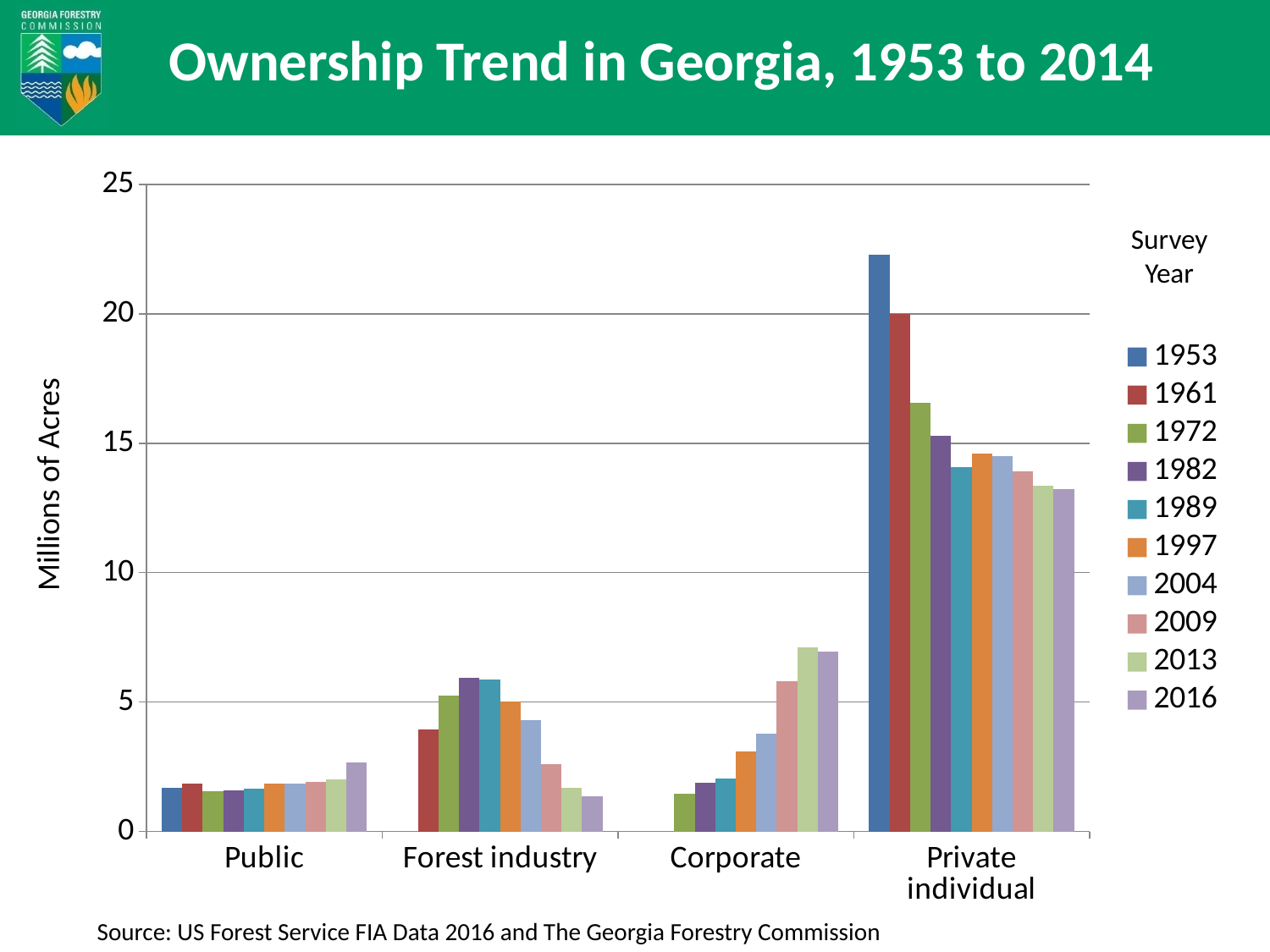
Which ownership category has the tallest bar on the chart? Private individual What kind of chart is shown on the slide? bar chart Which is larger in 1961, Forest industry or Private individual? Private individual Do the Private individual values rise or fall from 1953 to 2016? fall Is the value for Private individual in 2016 greater or less than 15? less How many survey years does the legend list? 10 What is the label of the y axis? Millions of Acres For the Private individual category, which survey year has the highest value? 1953 Is the value for Private individual in 1953 greater or less than 20? greater Is the value for Corporate in 2013 greater or less than 5? greater How many ownership categories are shown on the x axis? 4 What is the title of the legend? Survey Year